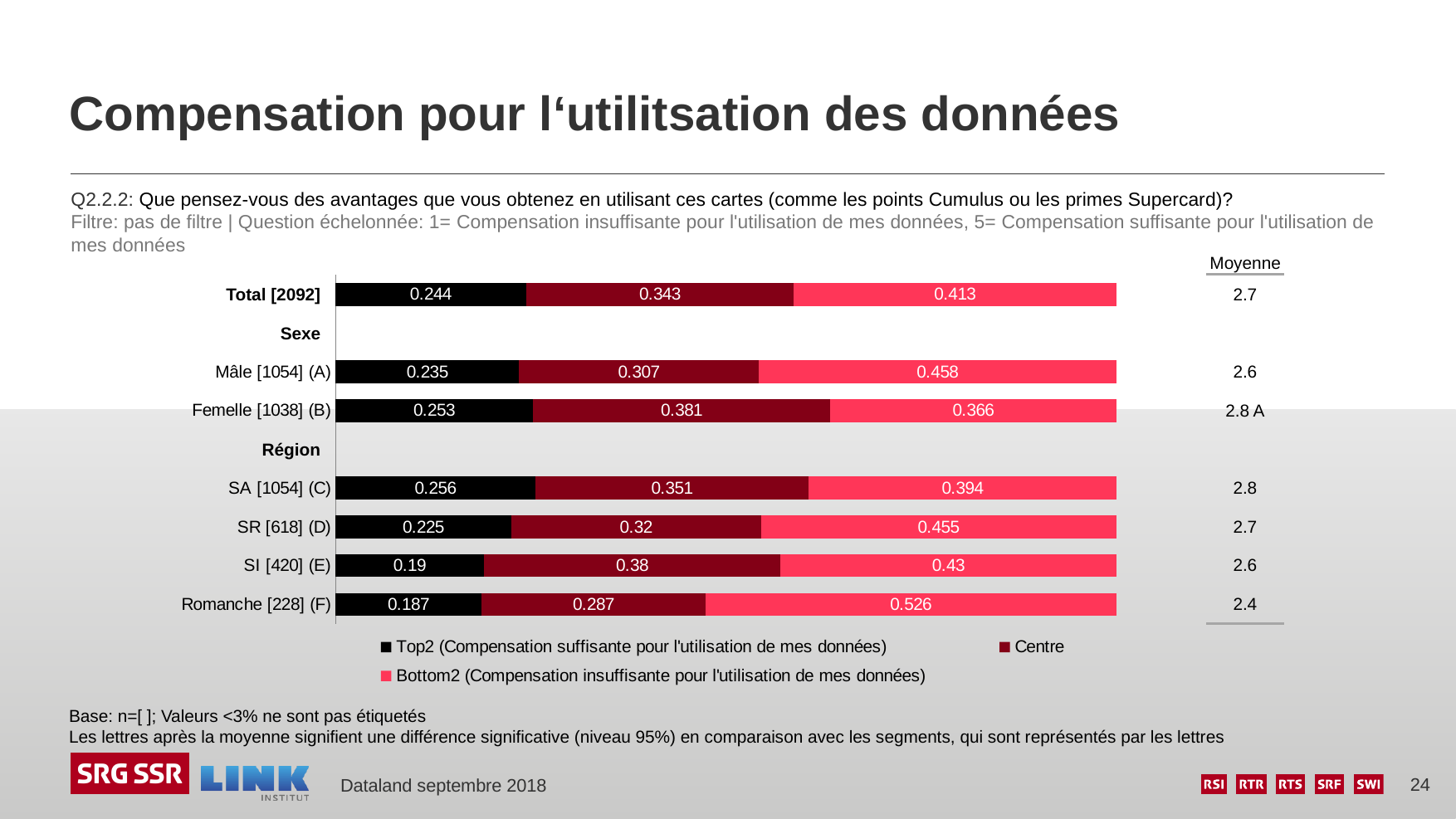
Which is larger, the Centre value for SI [420] (E) or the Centre value for SR [618] (D)? SI [420] (E) What is the difference between the Bottom2 values for Mâle [1054] (A) and Femelle [1038] (B)? 0.092 What is the Bottom2 value for Romanche [228] (F)? 0.526 What is the total of the three segments for SI [420] (E)? 1 What is the Moyenne shown for SA [1054] (C)? 2.8 Which category has the lowest Top2 value? Romanche [228] (F) How many series does the legend list? 3 What is the Centre value for Femelle [1038] (B)? 0.381 Which category has the highest Bottom2 value? Romanche [228] (F) What kind of chart is shown on the slide? Stacked bar chart How many categories have bars plotted in the chart? 7 What is the Top2 value for Total [2092]? 0.244